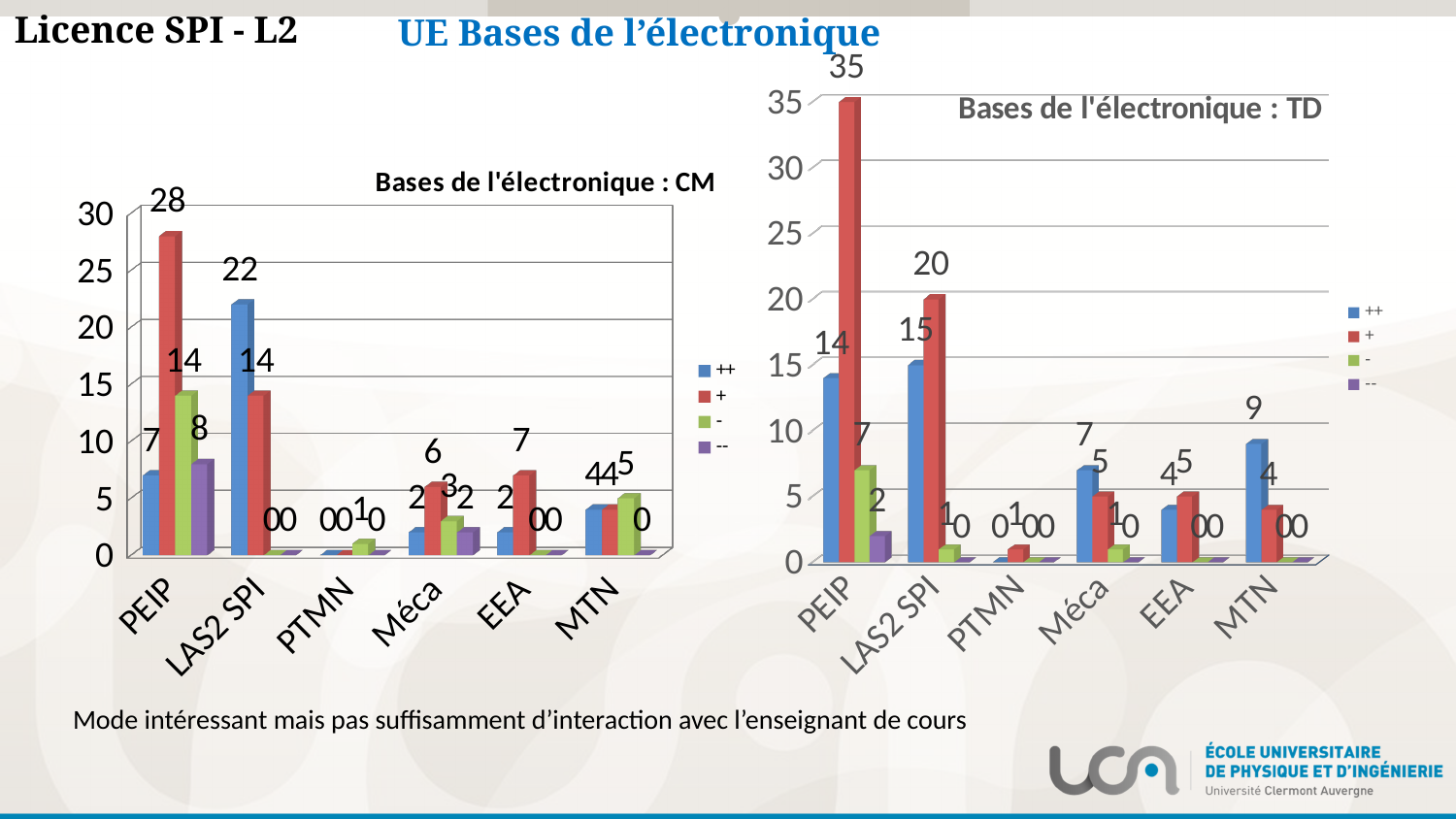
What type of chart is 'Bases de l'électronique : TD'? Bar chart How many series does the legend of the 'Bases de l'électronique : CM' chart list? 4 In the 'Bases de l'électronique : TD' chart, which category has the highest '+' value? PEIP In the 'Bases de l'électronique : TD' chart, what is the value of the '++' series for MTN? 9 In the 'Bases de l'électronique : TD' chart, what is the difference between the '+' value for PEIP and the '+' value for LAS2 SPI? 15 In the 'Bases de l'électronique : CM' chart, which is larger for Méca: the '+' value or the '-' value? + In the 'Bases de l'électronique : TD' chart, what is the value of the '++' series for LAS2 SPI? 15 In the 'Bases de l'électronique : CM' chart, what is the value of the '++' series for LAS2 SPI? 22 In the 'Bases de l'électronique : TD' chart, what is the value of the '+' series for PEIP? 35 In the 'Bases de l'électronique : CM' chart, what is the value of the '+' series for PEIP? 28 How many categories are shown on the x axis of the 'Bases de l'électronique : TD' chart? 6 In the 'Bases de l'électronique : CM' chart, which category has the highest '++' value? LAS2 SPI